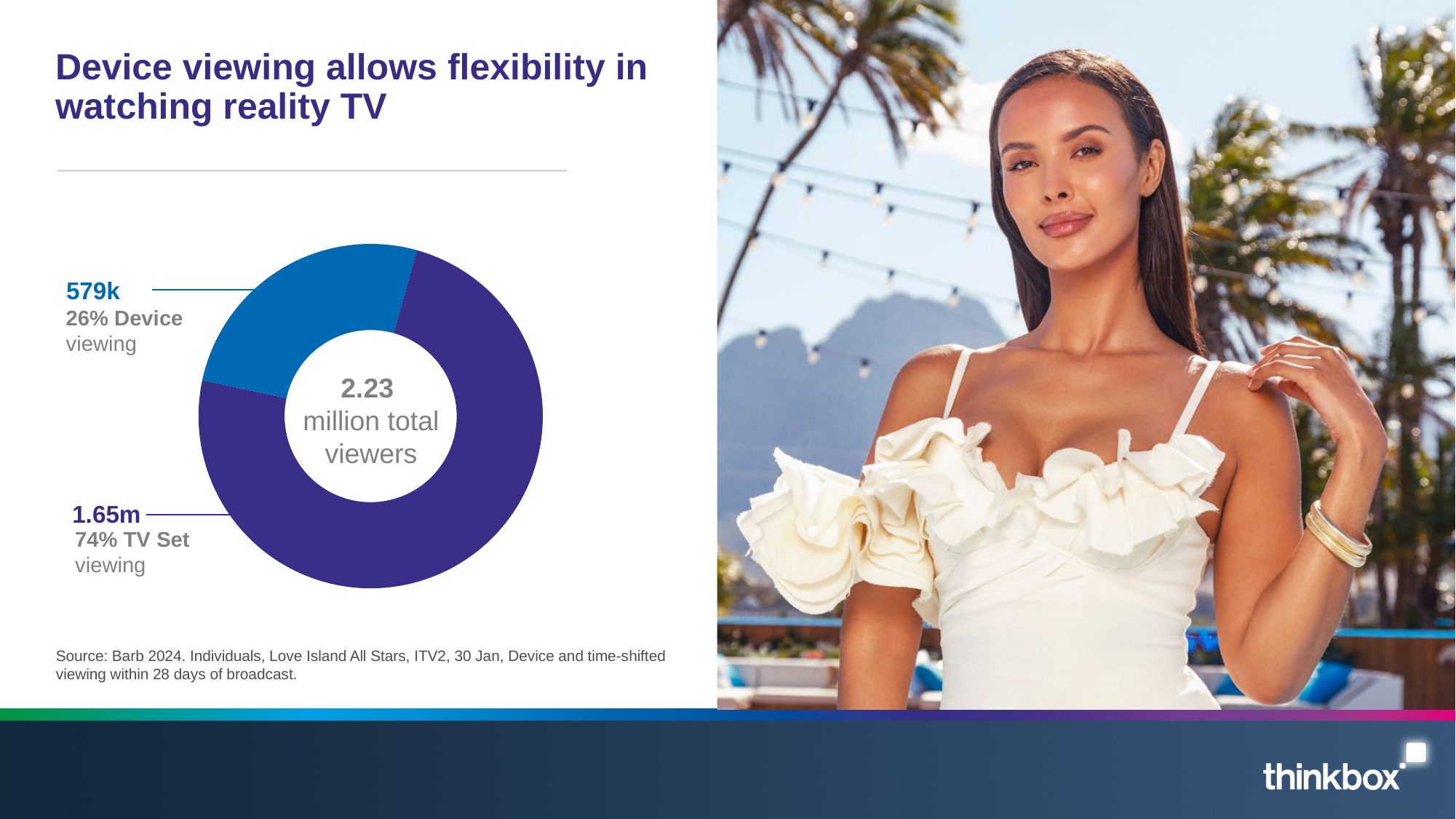
How many viewers does TV Set viewing account for? 1.65m What colour is the Device viewing segment? Blue What share of viewing is Device viewing? 26% What is the total number of viewers shown in the centre of the chart? 2.23 million Which category has the smallest share of viewers? Device viewing What share of viewing is TV Set viewing? 74% Which segment is larger, Device viewing or TV Set viewing? TV Set viewing What kind of chart is shown on the slide? Doughnut (pie) chart How many viewers does Device viewing account for? 579k What is the difference in percentage points between TV Set viewing and Device viewing? 48 percentage points What is the title of the slide? Device viewing allows flexibility in watching reality TV How many segments does the chart have? 2